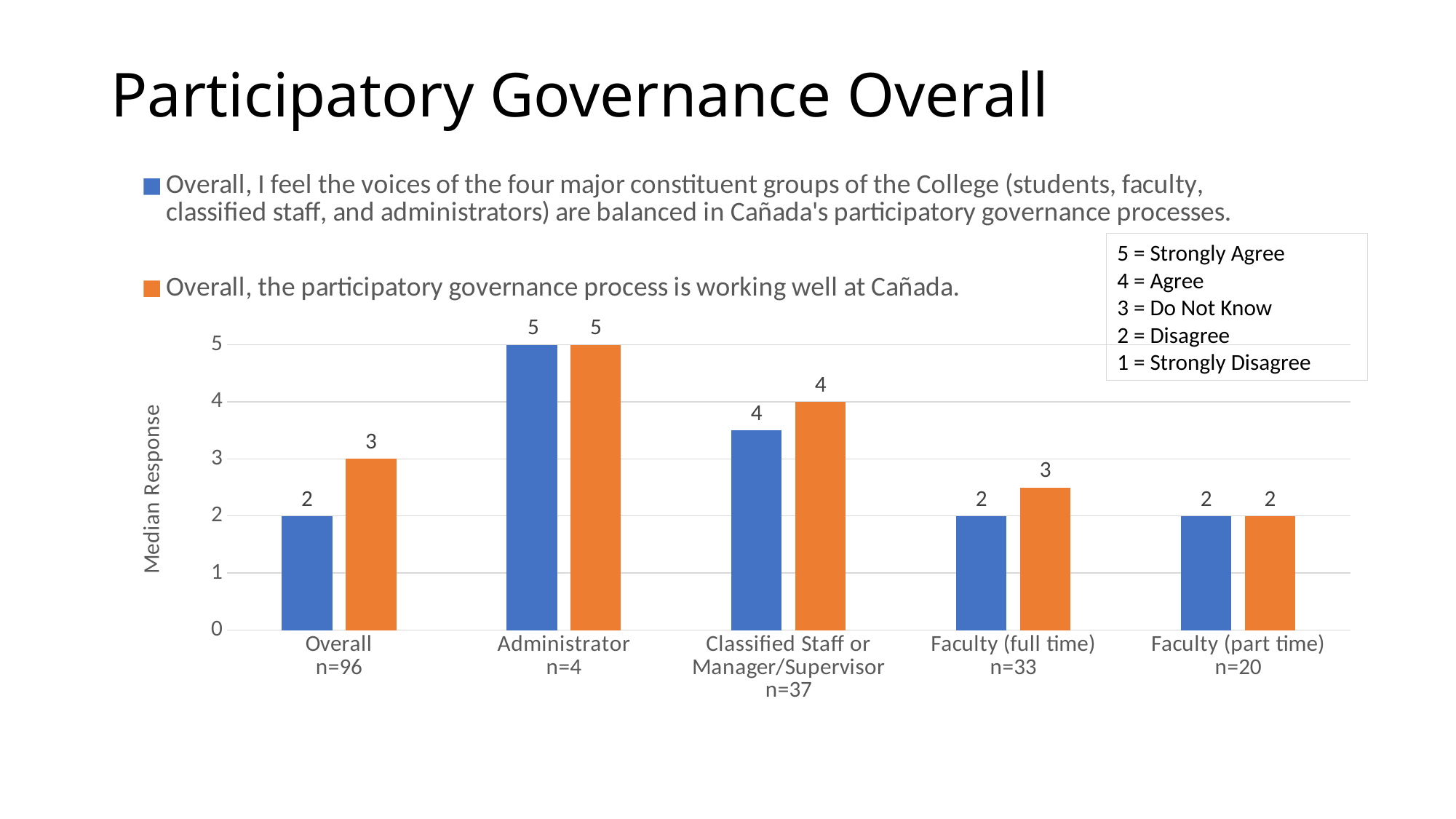
How many groups are shown on the x axis of the chart? 5 Is the median response for Administrator on the blue series greater or less than 4? greater How many series does the chart's legend list? 2 What is the difference between the two series' median responses for Overall (n=96)? 1 What is the median response for Overall (n=96) on the series "Overall, I feel the voices of the four major constituent groups of the College ... are balanced in Cañada's participatory governance processes."? 2 What is the label of the vertical axis of the chart? Median Response What is the median response for Administrator on the series "Overall, the participatory governance process is working well at Cañada."? 5 Which group has the highest median response on the series "Overall, the participatory governance process is working well at Cañada."? Administrator What is the median response for Faculty (part time) on the series "Overall, the participatory governance process is working well at Cañada."? 2 For Overall (n=96), which series has the larger median response? Overall, the participatory governance process is working well at Cañada. What is the sample size (n) shown for Classified Staff or Manager/Supervisor? n=37 What kind of chart is shown on the slide? Bar chart